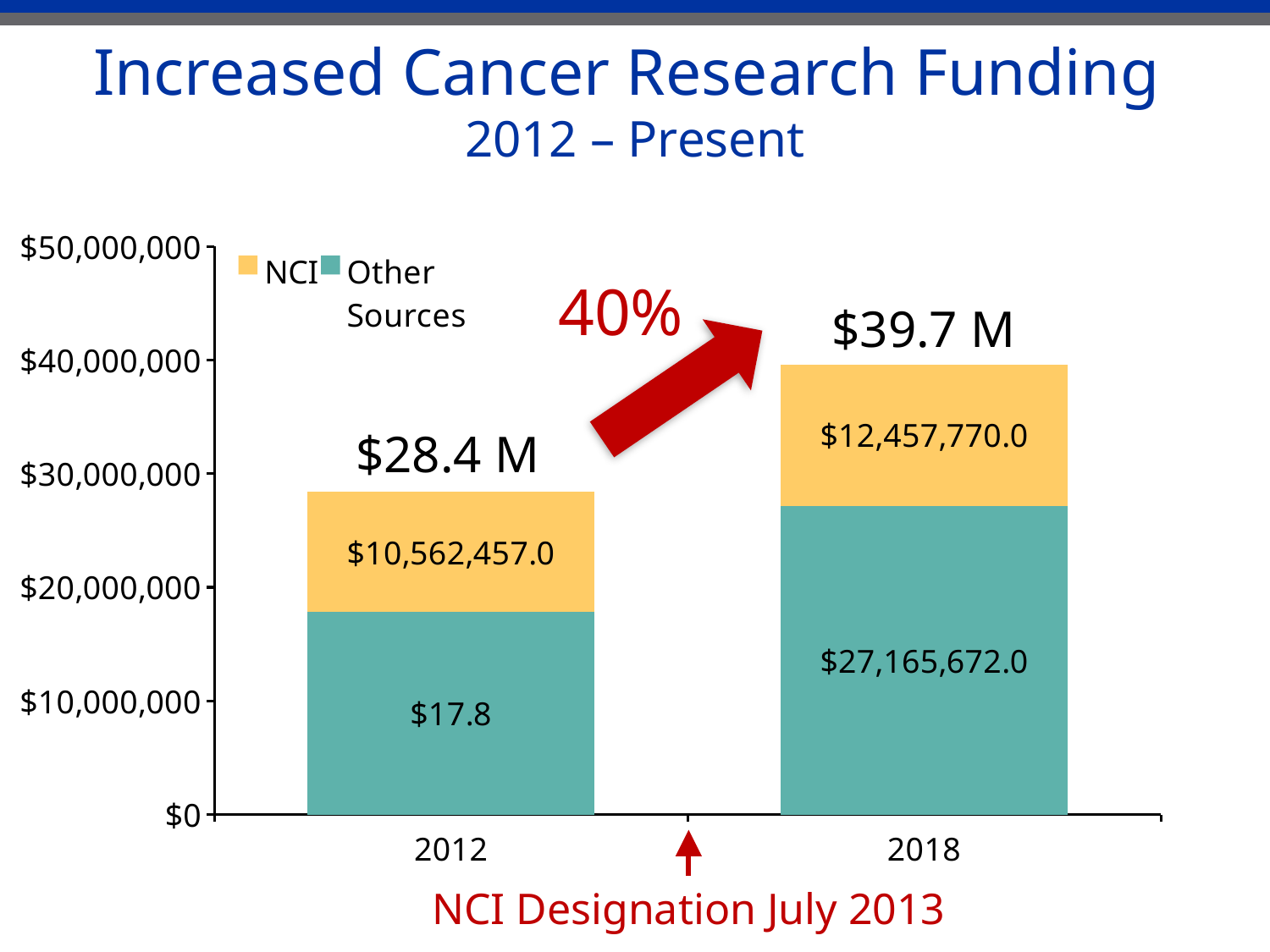
Which year has the higher total funding, 2012 or 2018? 2018 What kind of chart is shown on the slide? Stacked bar chart What is the total funding labelled above the 2018 bar? $39.7 M What is the NCI funding value shown for 2018? $12,457,770.0 Is the total funding for 2012 greater or less than $30,000,000? less What percentage increase is annotated on the arrow between the two bars? 40% What is the difference between the NCI funding in 2018 and in 2012? $1,895,313.0 What is the Other Sources funding value shown for 2018? $27,165,672.0 What is the total funding labelled above the 2012 bar? $28.4 M How many years are shown on the x axis? 2 How many series does the legend list? 2 What is the NCI funding value shown for 2012? $10,562,457.0